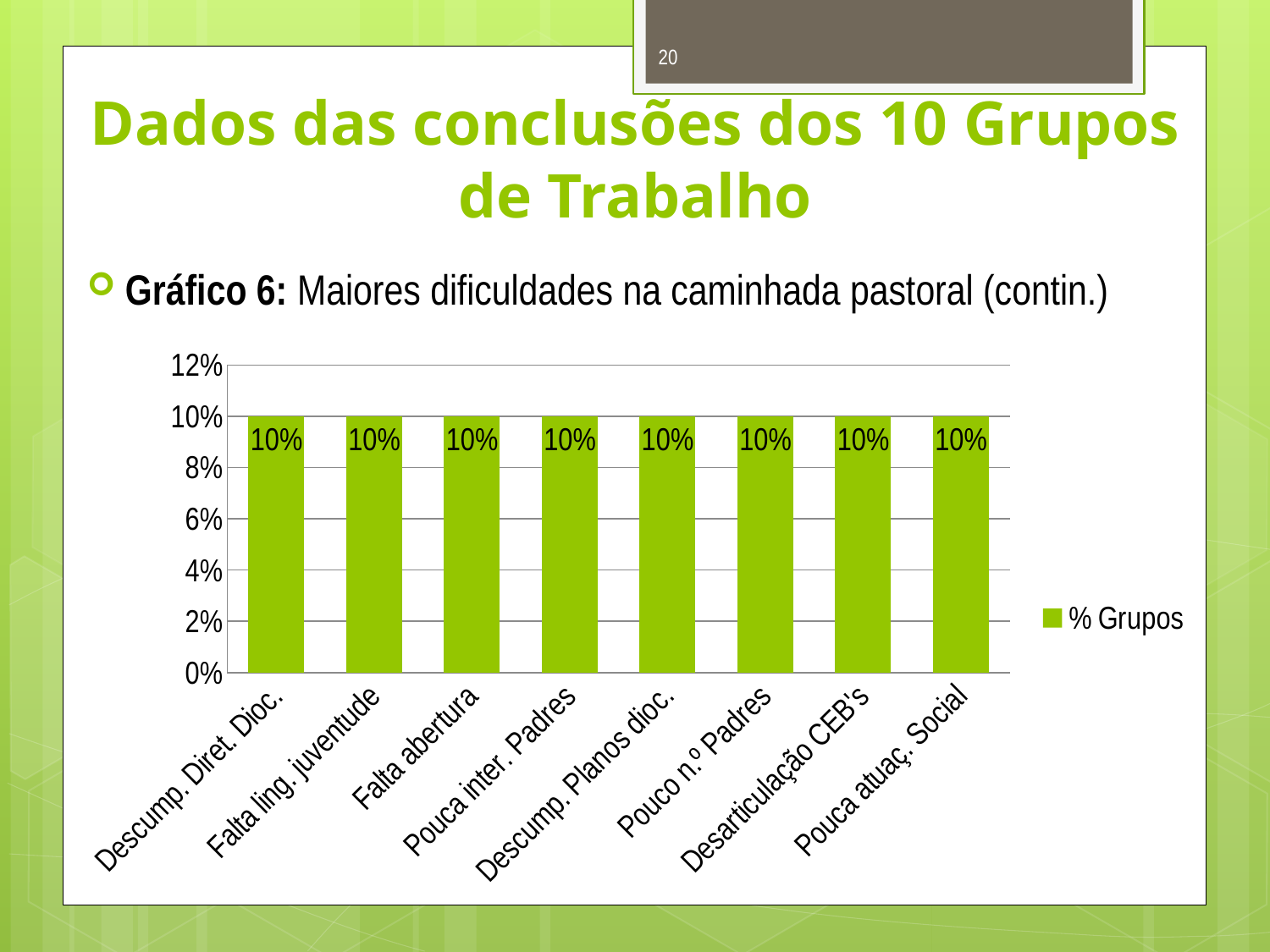
How many series does the legend list? 1 Is the value for Descump. Planos dioc. greater or less than 12%? less Is the value for Pouca inter. Padres greater or less than 8%? greater What is the value for Desarticulação CEB's? 10% What kind of chart is shown on the slide? bar chart What is the value for Pouca atuaç. Social? 10% What is the value for Falta abertura? 10% What is the value for Descump. Diret. Dioc.? 10% How many categories are shown on the x axis of the chart? 8 What is the name of the series listed in the legend? % Grupos Do the values rise, fall or stay the same across the categories along the x axis? stay the same What is the difference between the values for Falta ling. juventude and Pouco n.º Padres? 0%